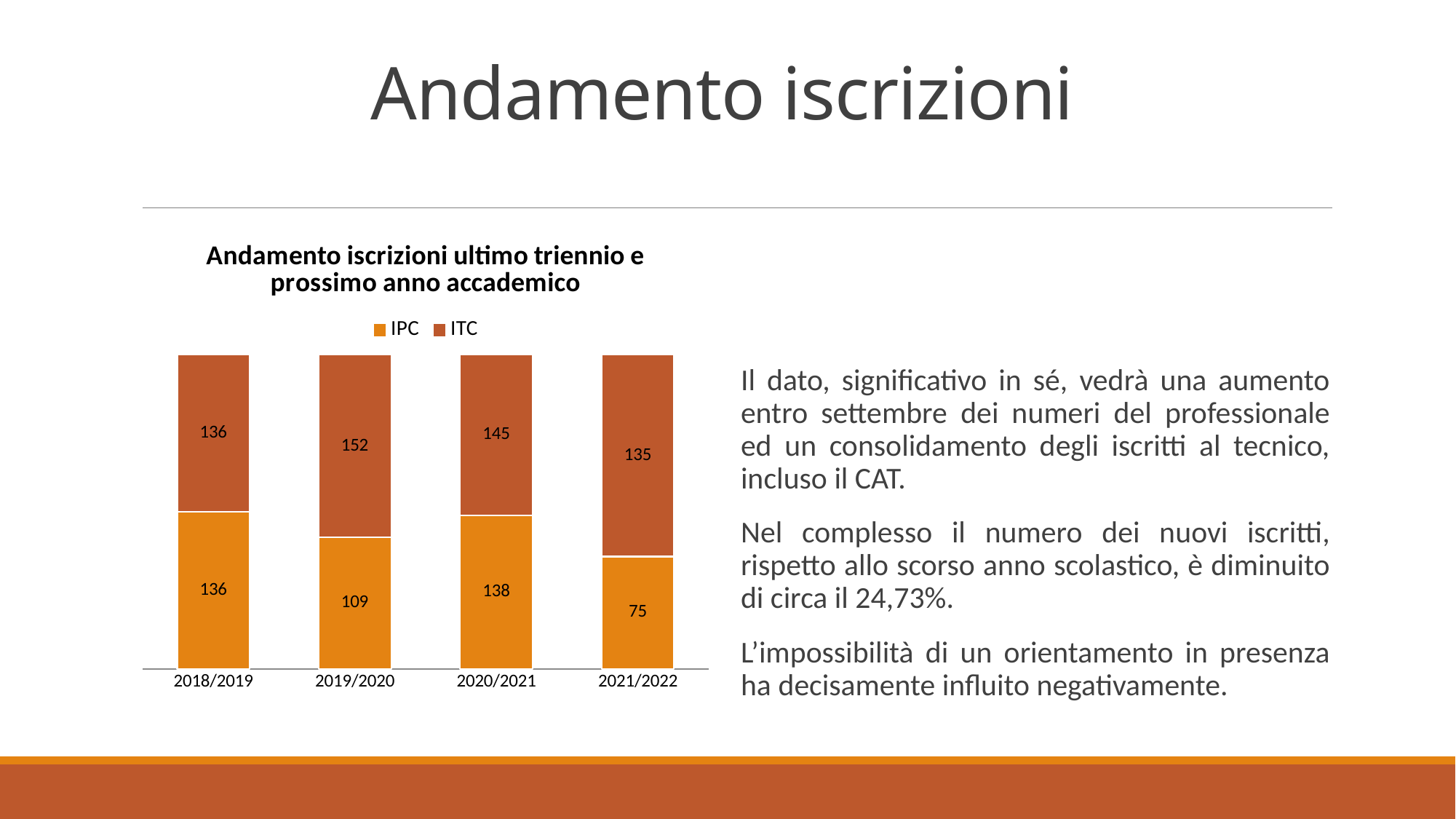
What is the difference between the ITC and IPC values for 2021/2022? 60 Which year has the lowest IPC value? 2021/2022 What is the IPC value for 2021/2022? 75 How many years are shown on the x axis? 4 What is the ITC value for 2020/2021? 145 What is the IPC value for 2019/2020? 109 What kind of chart is shown on the slide? Stacked bar chart What is the total of IPC and ITC for 2020/2021? 283 How many series does the legend list? 2 Which year has the highest ITC value? 2019/2020 Which is larger for 2019/2020, the IPC value or the ITC value? ITC What is the title of the chart? Andamento iscrizioni ultimo triennio e prossimo anno accademico